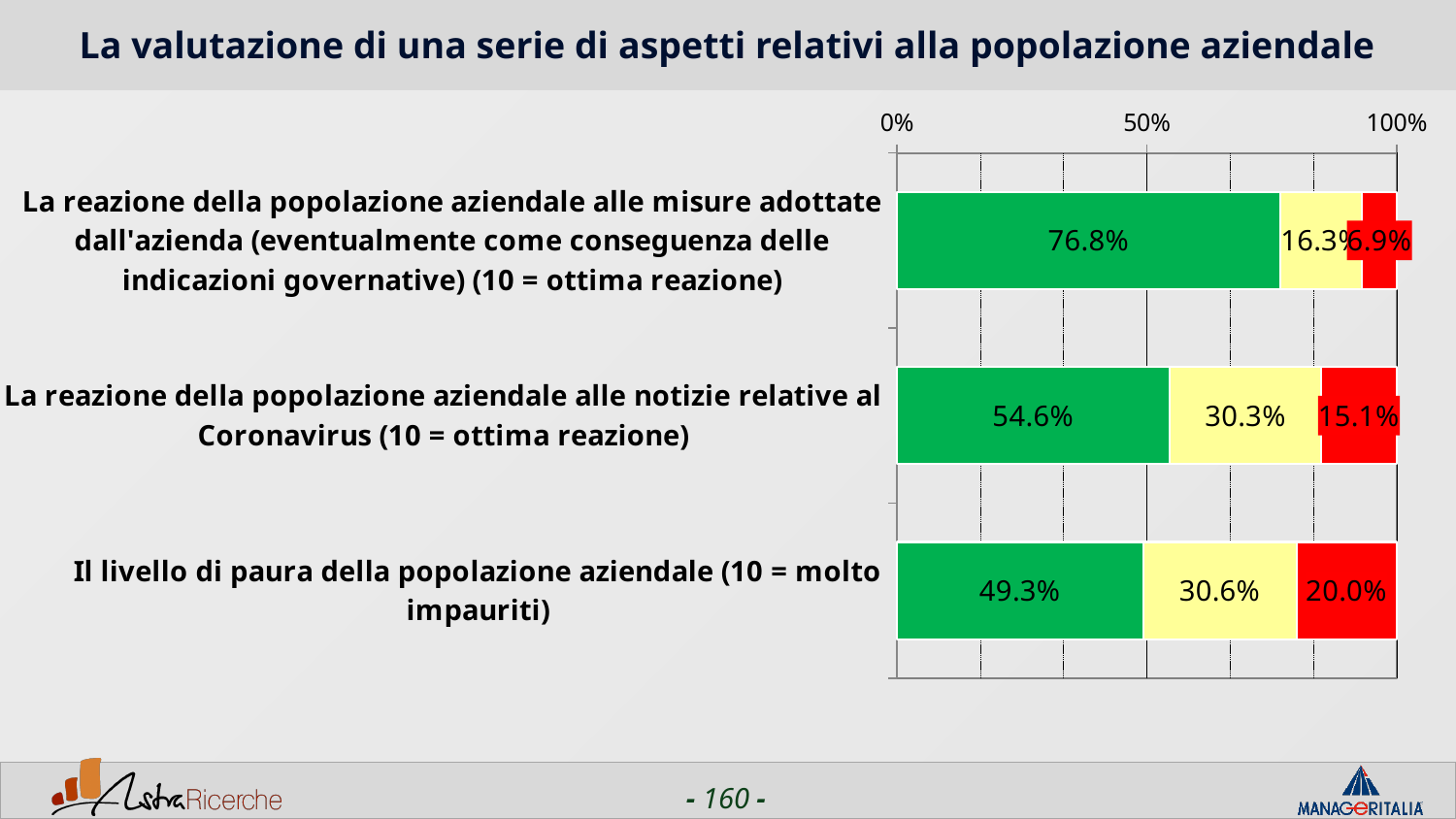
Which category has the largest green segment? La reazione della popolazione aziendale alle misure adottate dall'azienda Is the green segment for 'Il livello di paura della popolazione aziendale' greater or less than 50%? less What is the title of the slide? La valutazione di una serie di aspetti relativi alla popolazione aziendale What is the difference between the green segment values for 'La reazione della popolazione aziendale alle notizie relative al Coronavirus' and 'Il livello di paura della popolazione aziendale'? 5.3% What is the value of the yellow segment for 'Il livello di paura della popolazione aziendale'? 30.6% Which category has the smallest red segment? La reazione della popolazione aziendale alle misure adottate dall'azienda How many categories (bars) does the chart show? 3 What is the value of the red segment for 'La reazione della popolazione aziendale alle notizie relative al Coronavirus'? 15.1% What kind of chart is shown on the slide? bar chart What is the value of the green segment for 'La reazione della popolazione aziendale alle misure adottate dall'azienda'? 76.8% What is the value of the yellow segment for 'La reazione della popolazione aziendale alle misure adottate dall'azienda'? 16.3% Which is larger: the red segment for 'Il livello di paura della popolazione aziendale' or the red segment for 'La reazione della popolazione aziendale alle notizie relative al Coronavirus'? Il livello di paura della popolazione aziendale